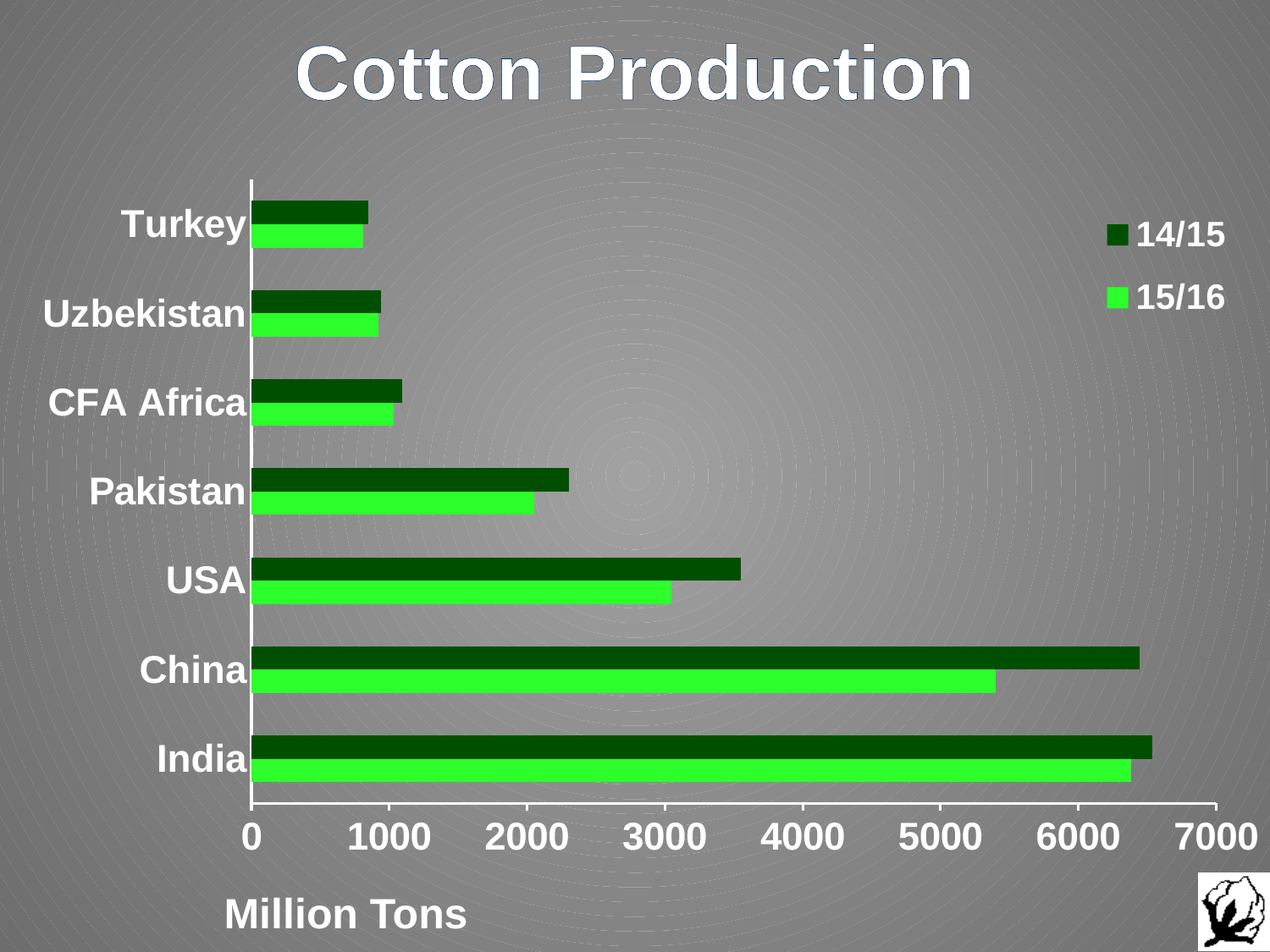
For USA, which season has the larger value, 14/15 or 15/16? 14/15 Is the 14/15 value for Pakistan greater or less than 2000? greater What kind of chart is shown on the slide? bar chart Which country has the lowest cotton production in 15/16? Turkey Which country has the highest cotton production in 15/16? India How many countries or regions are shown on the chart? 7 What unit label is shown below the x axis? Million Tons For China, which season has the larger value, 14/15 or 15/16? 14/15 Is the 15/16 value for China greater or less than 5000? greater How many series does the legend list? 2 Is the 14/15 value for USA greater or less than 3000? greater